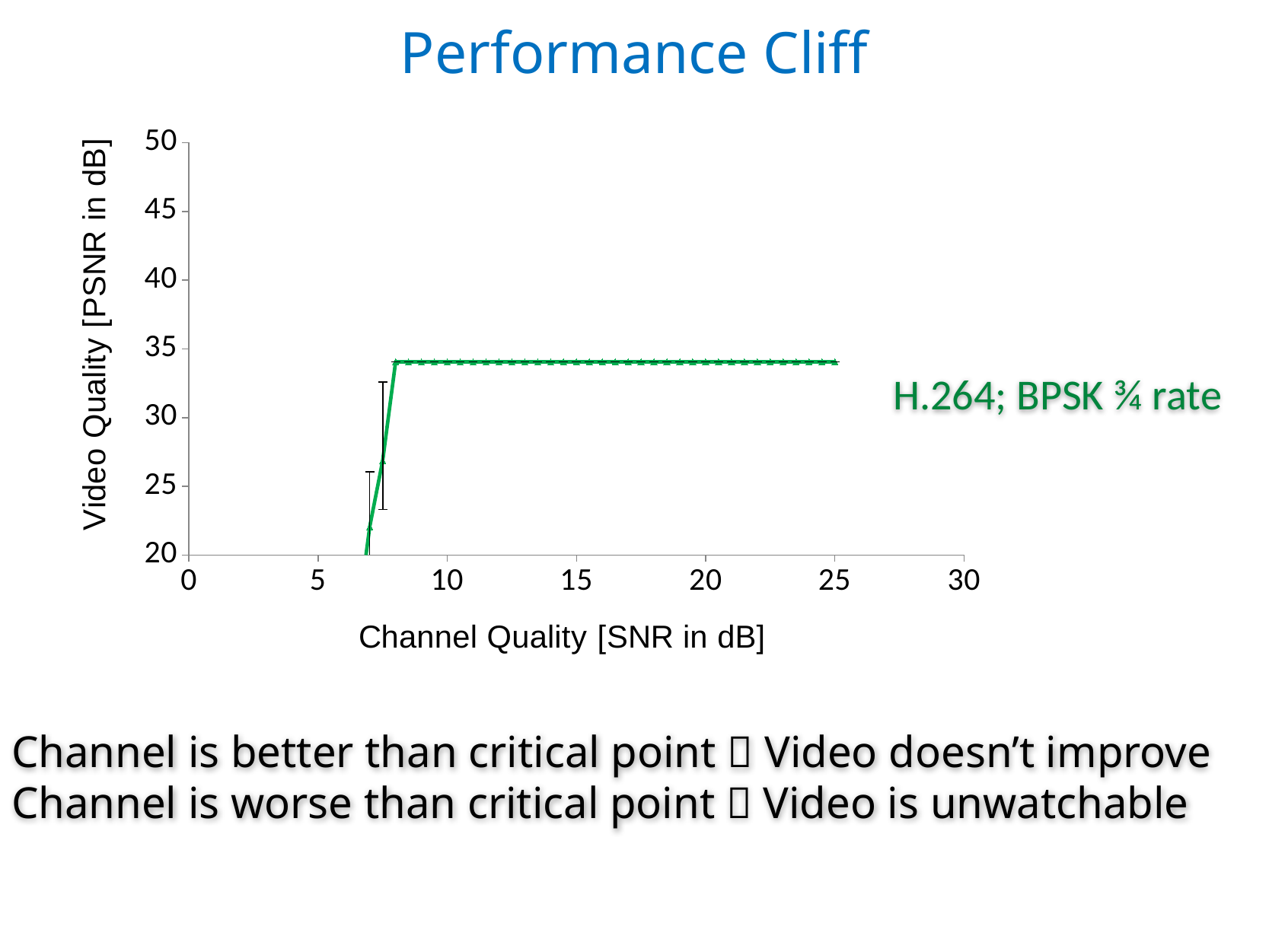
Is the video quality at a channel quality of 7 dB SNR greater or less than 30? less How does the video quality change as channel quality increases from about 7 dB to 8 dB SNR? rises sharply Is the video quality at a channel quality of 25 dB SNR greater or less than 25? greater What is the highest value shown on the y axis? 50 What kind of chart is shown on the slide? line chart How does the video quality change as channel quality increases from 10 dB to 25 dB SNR? stays flat Is the video quality at a channel quality of 15 dB SNR greater or less than 40? less What is the title of the chart on the slide? Performance Cliff What series label is shown next to the plotted line? H.264; BPSK ¾ rate Is the video quality at 10 dB SNR larger or smaller than at 7 dB SNR? larger How many data series are plotted on the chart? 1